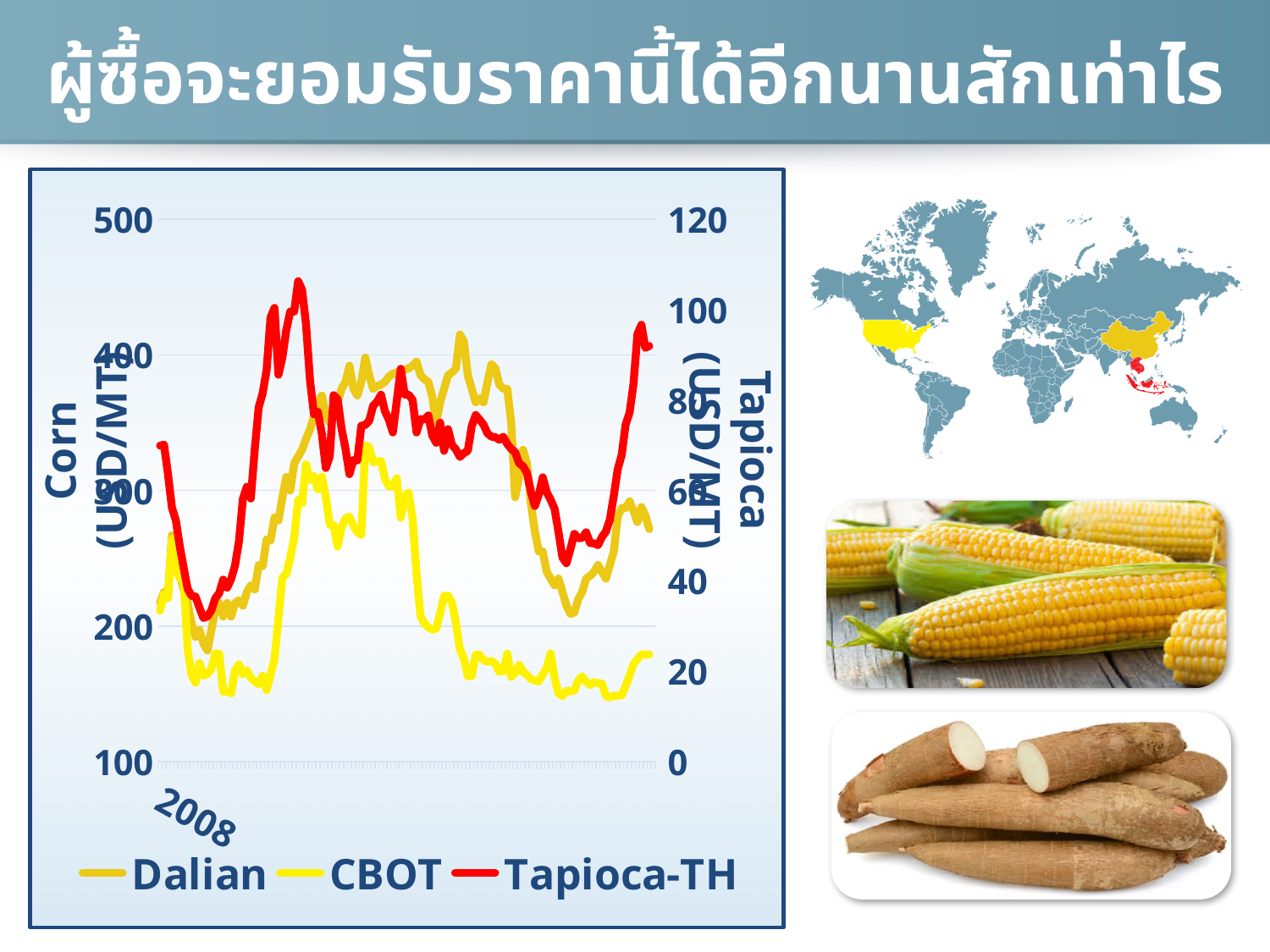
Is the value of the CBOT line at the far right end of the chart greater or less than 200 on the left axis? less Is the lowest value reached by the Dalian line greater or less than 300 on the left axis? less What kind of chart is shown on the slide? line chart Is the lowest value reached by the CBOT line greater or less than 200 on the left axis? less Which series are listed in the chart legend? Dalian, CBOT, Tapioca-TH What colour is the Tapioca-TH line in the chart? red How many series does the chart legend list? 3